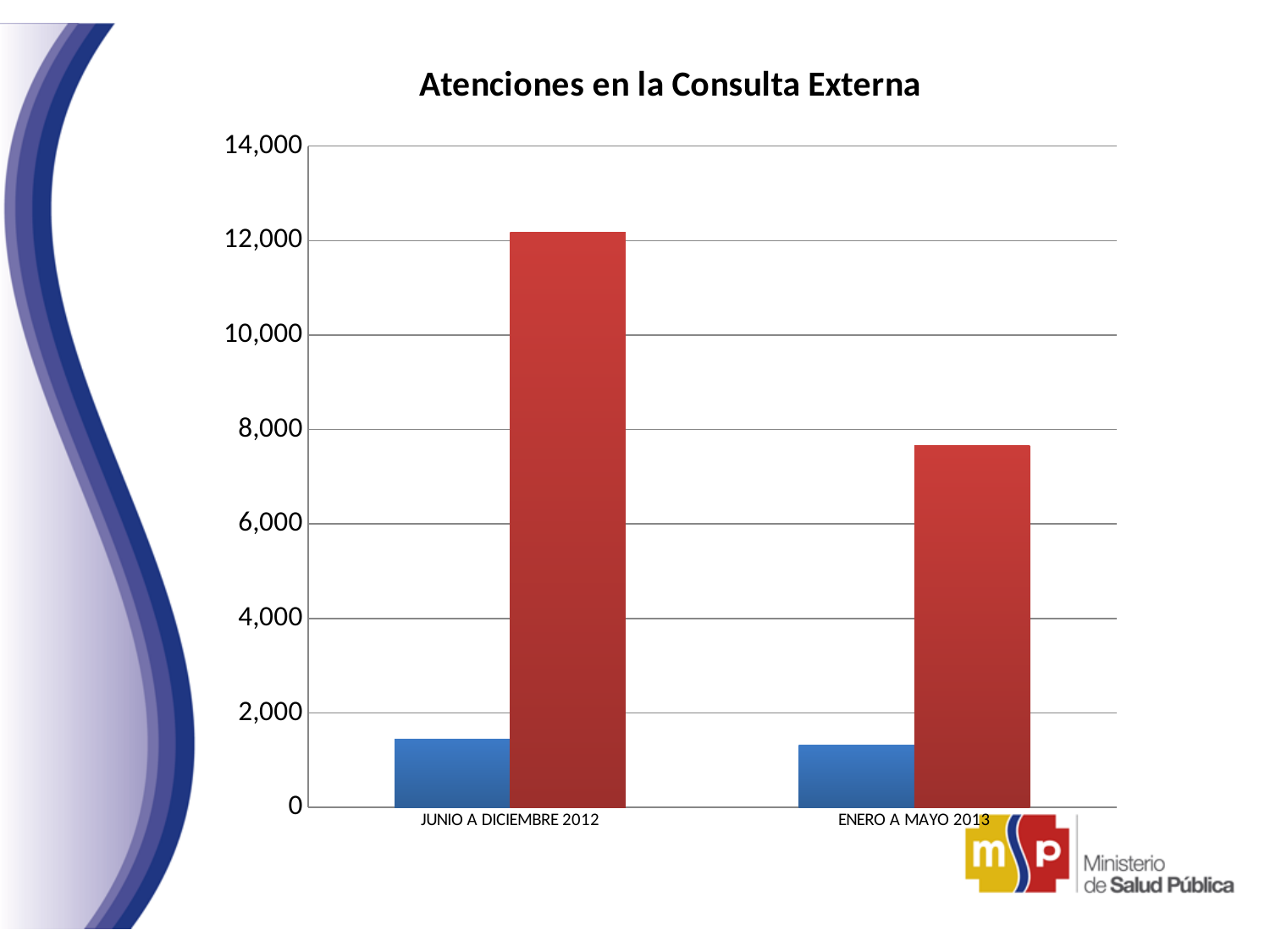
Is the value of the blue bar for JUNIO A DICIEMBRE 2012 greater or less than 2,000? less Is the value of the blue bar for ENERO A MAYO 2013 greater or less than 1,000? greater Is the value of the red bar for JUNIO A DICIEMBRE 2012 greater or less than 12,000? greater What is the highest value shown on the y axis? 14,000 Which bar is the tallest in the chart? the red bar for JUNIO A DICIEMBRE 2012 How many bars are plotted for each category? 2 What kind of chart is shown on the slide? bar chart Which category has the taller red bar, JUNIO A DICIEMBRE 2012 or ENERO A MAYO 2013? JUNIO A DICIEMBRE 2012 How many categories are shown on the x axis? 2 What is the title of the chart? Atenciones en la Consulta Externa Do the red bars rise or fall from JUNIO A DICIEMBRE 2012 to ENERO A MAYO 2013? fall